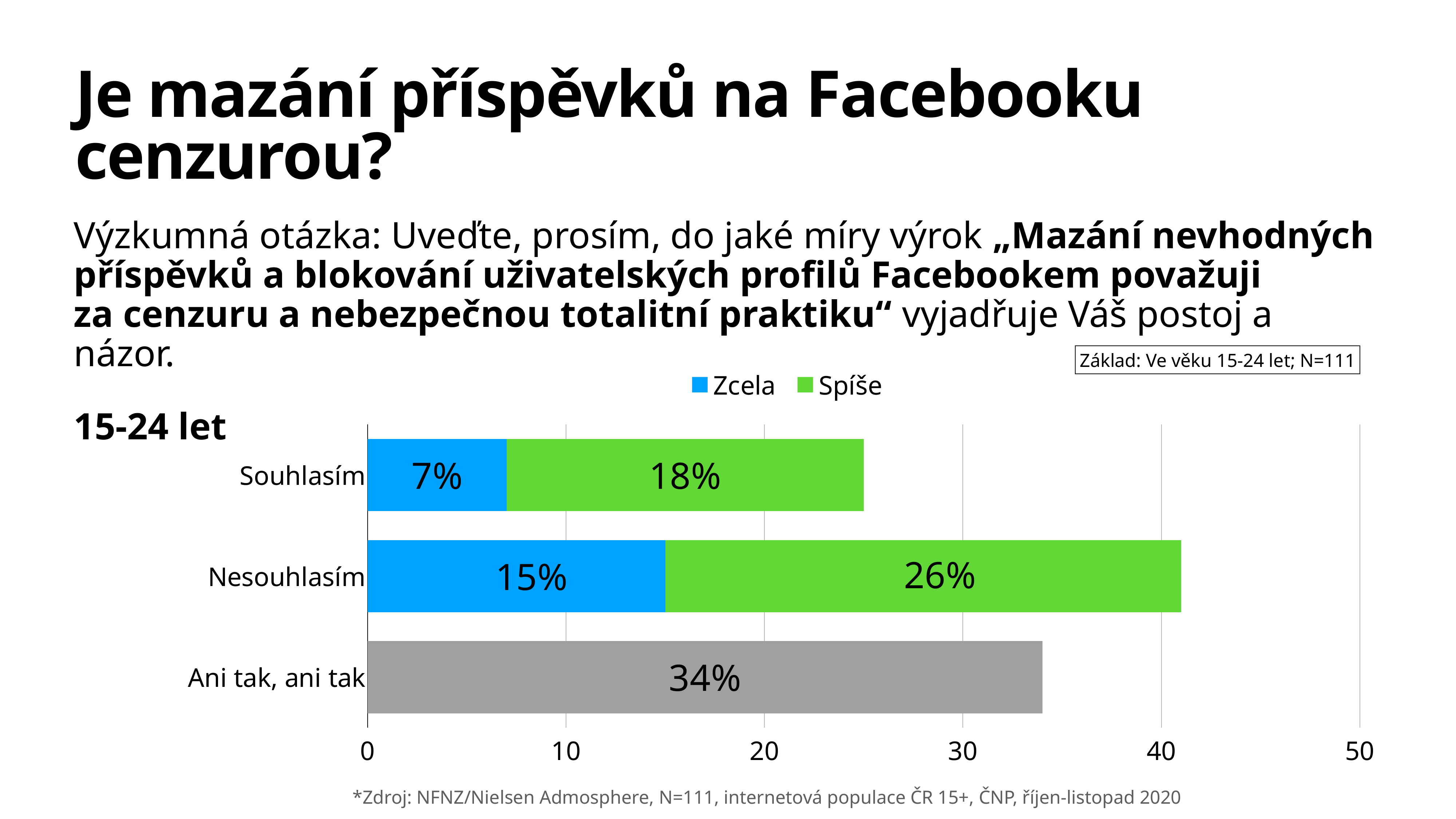
How many series does the legend list? 2 Which category has the longest bar overall? Nesouhlasím Which is larger: the 'Spíše' value for Nesouhlasím or for Souhlasím? Nesouhlasím What is the total of the stacked bar for Souhlasím? 25% What is the difference between the 'Zcela' values for Nesouhlasím and Souhlasím? 8% What is the total of the stacked bar for Nesouhlasím? 41% What is the 'Zcela' value for Souhlasím? 7% What is the value shown for 'Ani tak, ani tak'? 34% What kind of chart is shown on the slide? Bar chart How many categories are shown on the vertical axis? 3 What is the 'Spíše' value for Souhlasím? 18% What is the 'Spíše' value for Nesouhlasím? 26%